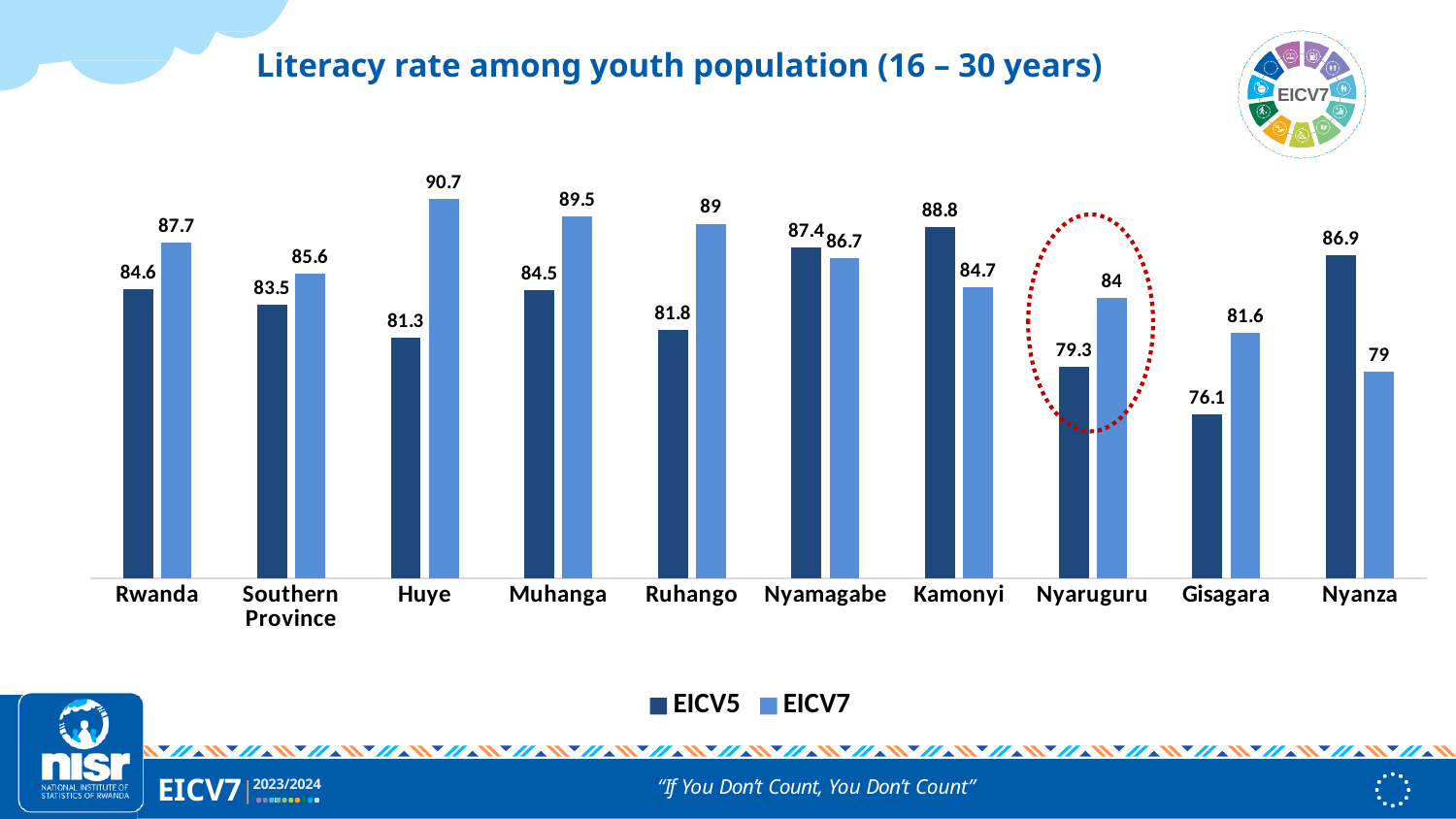
What is the EICV7 value for Southern Province? 85.6 What is the EICV5 literacy rate for Nyaruguru? 79.3 What is the difference between the EICV7 and EICV5 values for Huye? 9.4 How many categories are shown on the x axis? 10 By how much is the EICV5 value for Nyanza higher than its EICV7 value? 7.9 What type of chart is shown on the slide? Bar chart Which category has the lowest EICV5 literacy rate? Gisagara Which category has the highest EICV5 literacy rate? Kamonyi How many series does the legend list? 2 Which district or region has the highest EICV7 literacy rate? Huye What is the EICV7 literacy rate for Huye? 90.7 For Kamonyi, which is larger: the EICV5 value or the EICV7 value? EICV5